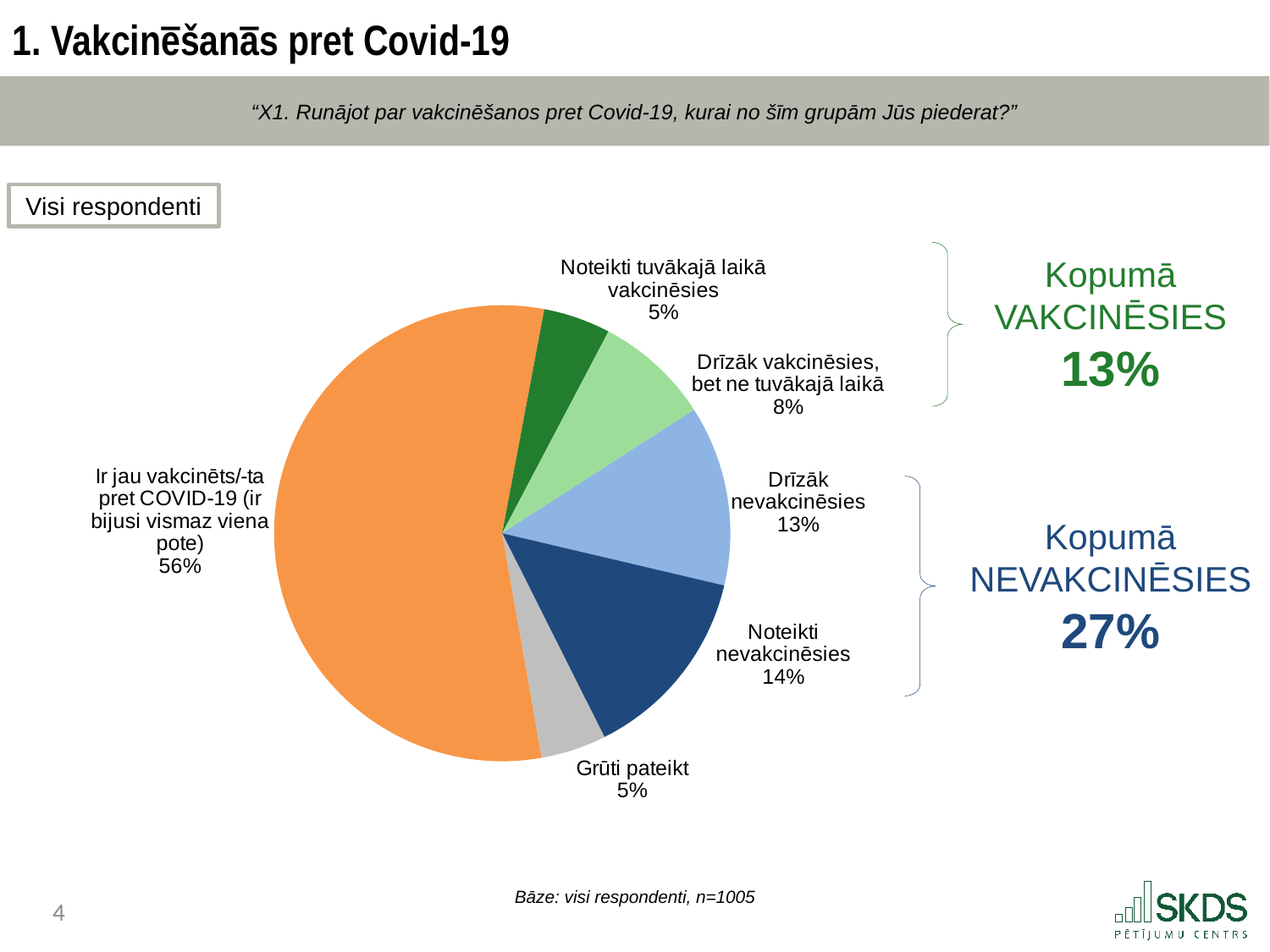
What is the base (n) stated for the chart? n=1005 What percentage of respondents answered 'Noteikti nevakcinēsies'? 14% What is the difference in percentage points between 'Noteikti nevakcinēsies' and 'Drīzāk nevakcinēsies'? 1 percentage point What percentage of respondents answered 'Grūti pateikt'? 5% What share of respondents are already vaccinated against COVID-19 (Ir jau vakcinēts/-ta pret COVID-19)? 56% Which is larger: 'Drīzāk vakcinēsies, bet ne tuvākajā laikā' or 'Noteikti tuvākajā laikā vakcinēsies'? Drīzāk vakcinēsies, bet ne tuvākajā laikā What is the combined share labelled 'Kopumā NEVAKCINĒSIES'? 27% What is the combined share labelled 'Kopumā VAKCINĒSIES'? 13% What type of chart is shown on the slide? pie chart What percentage of respondents answered 'Drīzāk vakcinēsies, bet ne tuvākajā laikā'? 8% How many slices does the pie chart have? 6 Which category has the largest slice of the pie? Ir jau vakcinēts/-ta pret COVID-19 (ir bijusi vismaz viena pote)